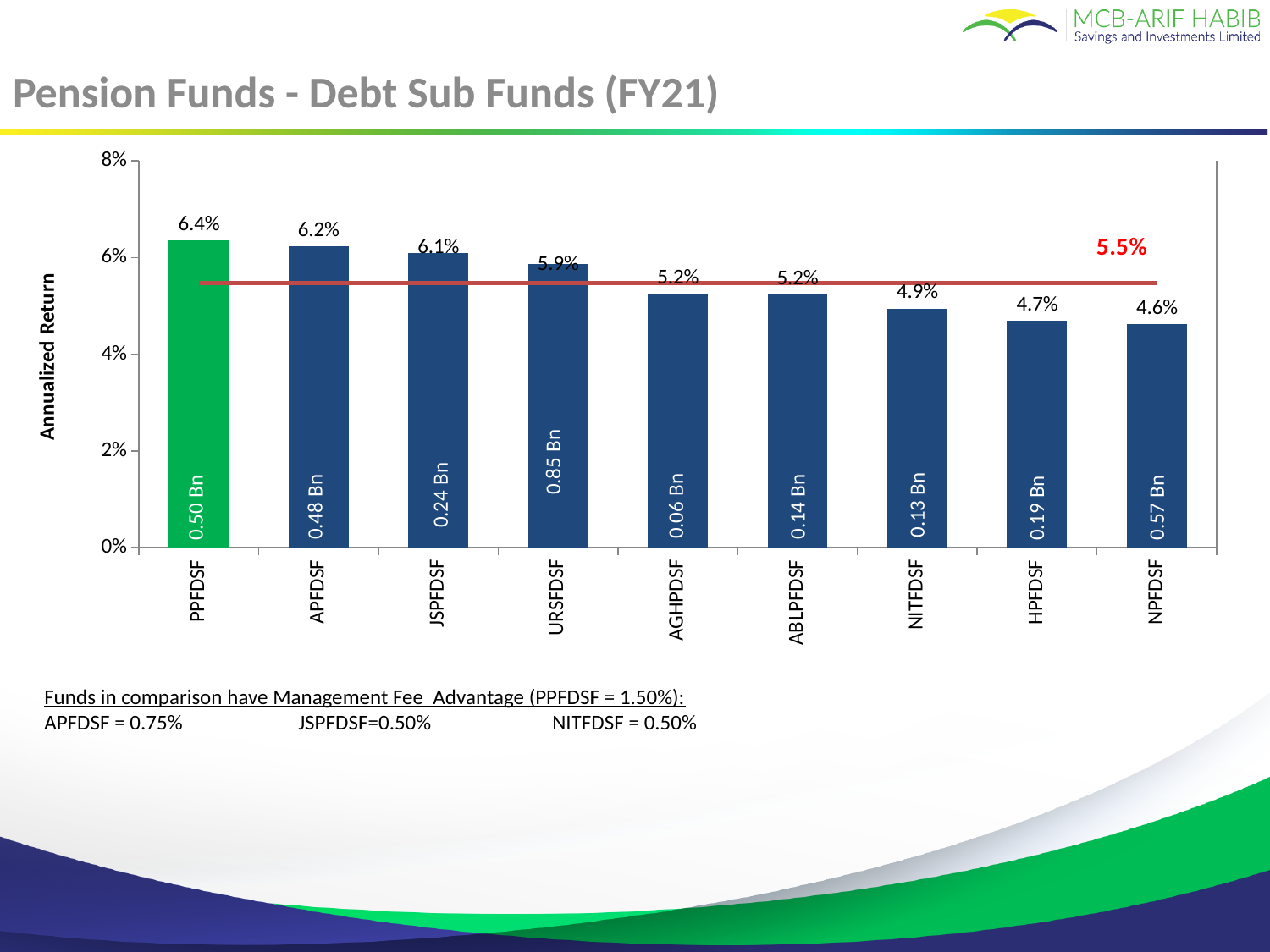
Which has a higher annualized return, APFDSF or HPFDSF? APFDSF What is the annualized return for PPFDSF? 6.4% What type of chart is shown on the slide? Bar chart What is the difference in annualized return between PPFDSF and NPFDSF? 1.8% What value is labelled on the red horizontal line? 5.5% Which fund has the lowest annualized return? NPFDSF Is the annualized return for AGHPDSF greater or less than 6%? less What is the annualized return for NITFDSF? 4.9% How many funds are shown on the chart? 9 Do the annualized returns rise or fall from left to right across the chart? Fall What fund size is printed inside the URSFDSF bar? 0.85 Bn Which fund has the highest annualized return? PPFDSF